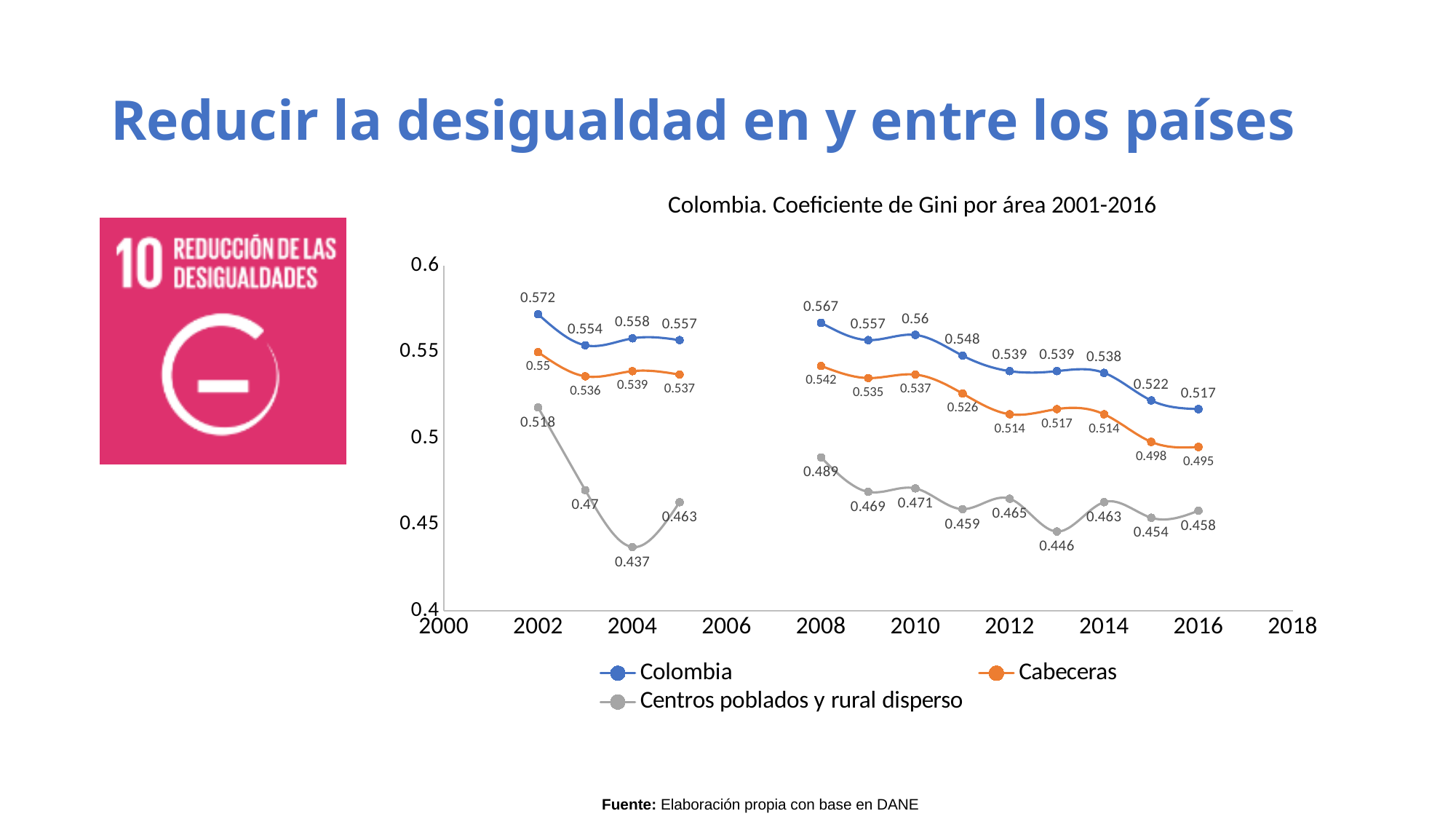
In which year does the Colombia series reach its highest value? 2002 Is the value for Centros poblados y rural disperso in 2008 greater or less than 0.5? less In which year does the Centros poblados y rural disperso series reach its lowest value? 2004 What is the difference between the Colombia value and the Cabeceras value in 2016? 0.022 What is the value for Centros poblados y rural disperso in 2004? 0.437 What is the value for Cabeceras in 2016? 0.495 What is the Gini coefficient for Colombia in 2002? 0.572 Which series has the higher value in 2012, Colombia or Cabeceras? Colombia What type of chart is shown on the slide? line chart Does the Colombia series generally rise or fall from 2008 to 2016? fall How many series does the legend list? 3 What is the title of the chart? Colombia. Coeficiente de Gini por área 2001-2016